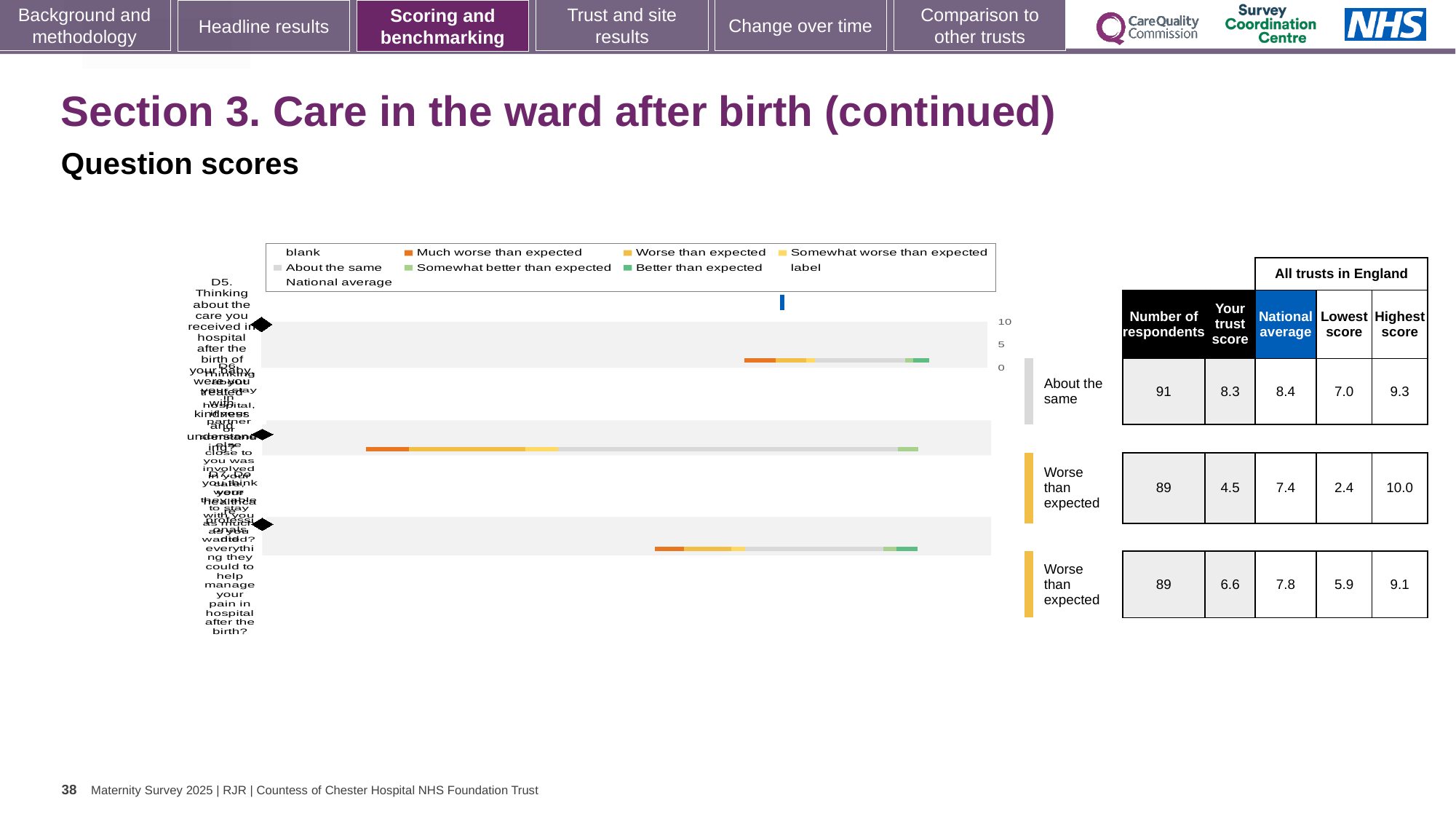
What is the highest value shown on the chart's score axis? 10 Which question row has the highest 'Your trust score'? the first row (About the same), 8.3 What is the national average for the second question row (the first row rated 'Worse than expected')? 7.4 Is 'Your trust score' for the second question row greater or less than 5? less How many question rows (bars) are plotted in the chart? 3 For the first question row, what is the difference between the national average and 'Your trust score'? 0.1 What is 'Your trust score' for the first question row, rated 'About the same'? 8.3 What colour does the legend use for 'About the same'? grey For the third question row, which is larger: 'Your trust score' or the national average? national average What kind of chart is shown on the slide? bar chart What is the number of respondents for the first question row? 91 Which question row has the lowest 'Your trust score'? the second row, 4.5